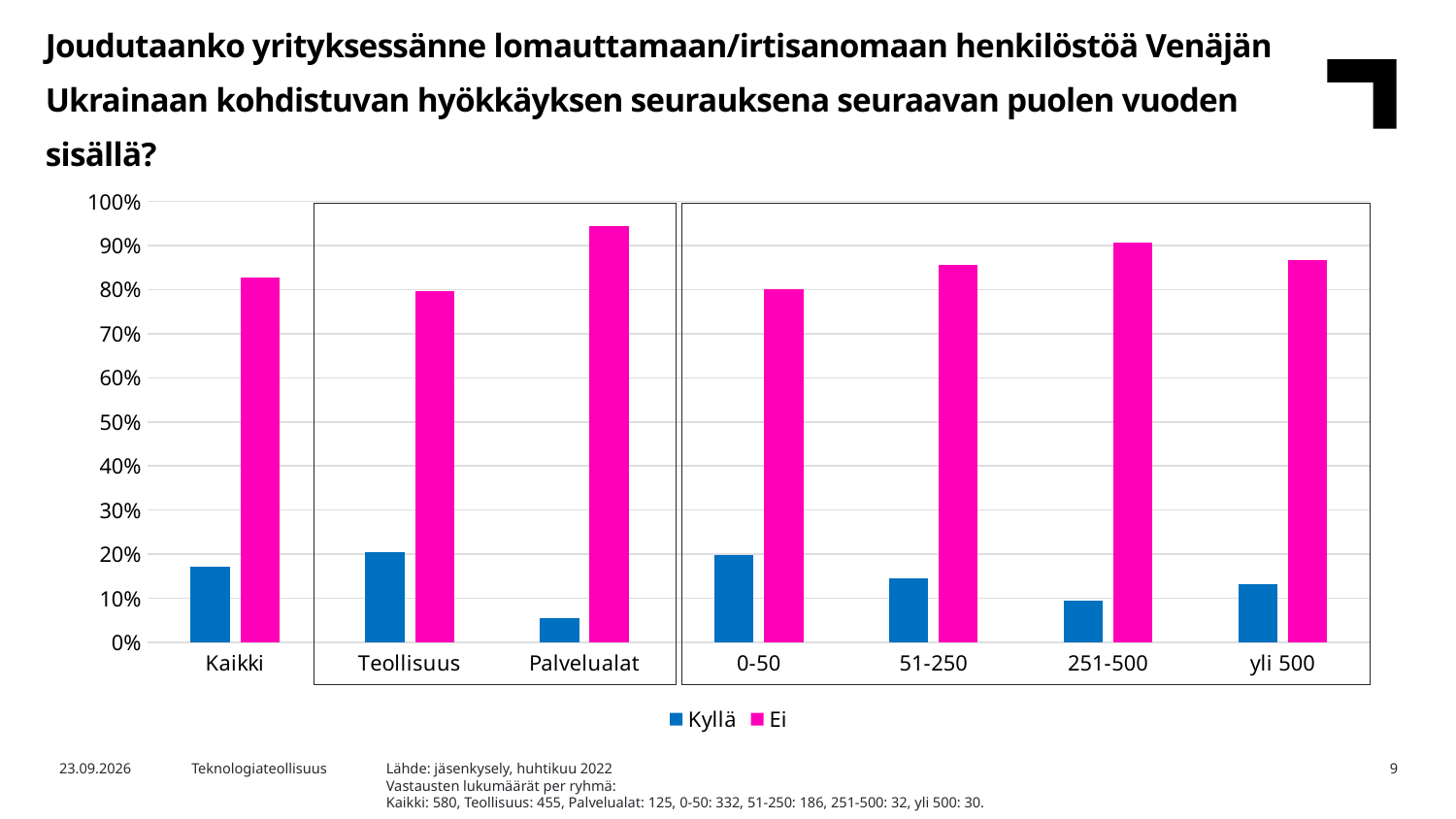
Which category has the highest value for the Ei series? Palvelualat How many categories are shown on the x axis? 7 Which is larger, the Kyllä value for Kaikki or the Kyllä value for Palvelualat? Kaikki How many series does the legend list? 2 Which colour represents the Ei series in the legend? magenta (pink) Is the Ei value for 0-50 greater or less than 90%? less Which category has the lowest value for the Kyllä series? Palvelualat Is the Ei value for Palvelualat greater or less than 90%? greater Which is larger, the Ei value for 251-500 or the Ei value for 0-50? 251-500 Is the Kyllä value for Kaikki greater or less than 20%? less What kind of chart is shown on the slide? bar chart